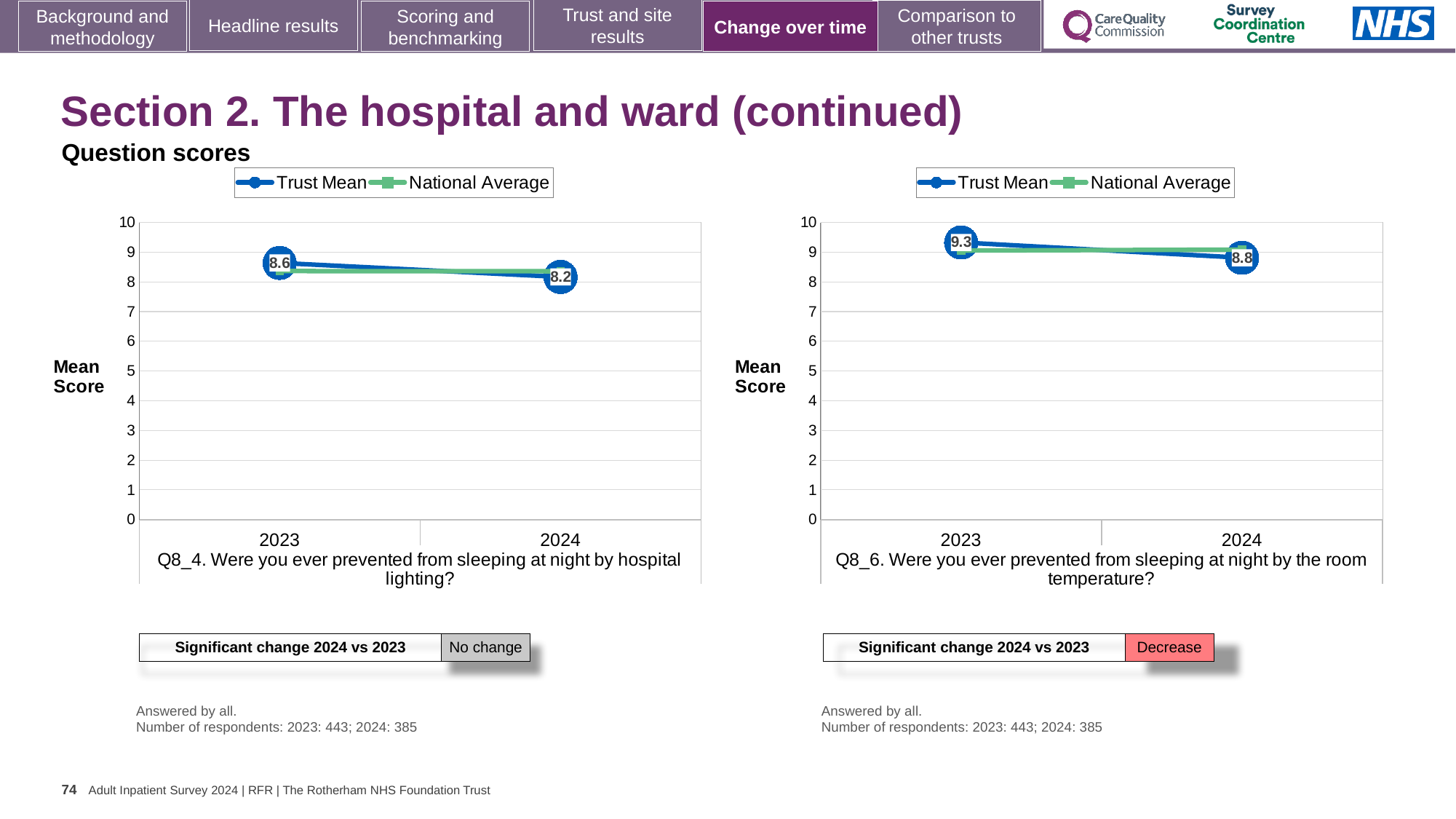
In the Q8_4 chart (left), what is the difference between the Trust Mean in 2023 and 2024? 0.4 In the Q8_6 chart (right), what is the Trust Mean for 2023? 9.3 What is the significant change result shown below the Q8_6 chart (right)? Decrease In the Q8_4 chart (left), which year has the higher Trust Mean? 2023 In the Q8_6 chart (right), does the Trust Mean rise or fall from 2023 to 2024? fall How many years are plotted on the x axis of the Q8_4 chart (left)? 2 In the Q8_6 chart (right), what is the Trust Mean for 2024? 8.8 How many series does the legend of the Q8_6 chart (right) list? 2 In the Q8_4 chart (left), what is the Trust Mean for 2024? 8.2 In the Q8_6 chart (right), what is the difference between the Trust Mean in 2023 and 2024? 0.5 What kind of chart is the Q8_4 chart (left)? line chart In the Q8_4 chart (left), what is the Trust Mean for 2023? 8.6